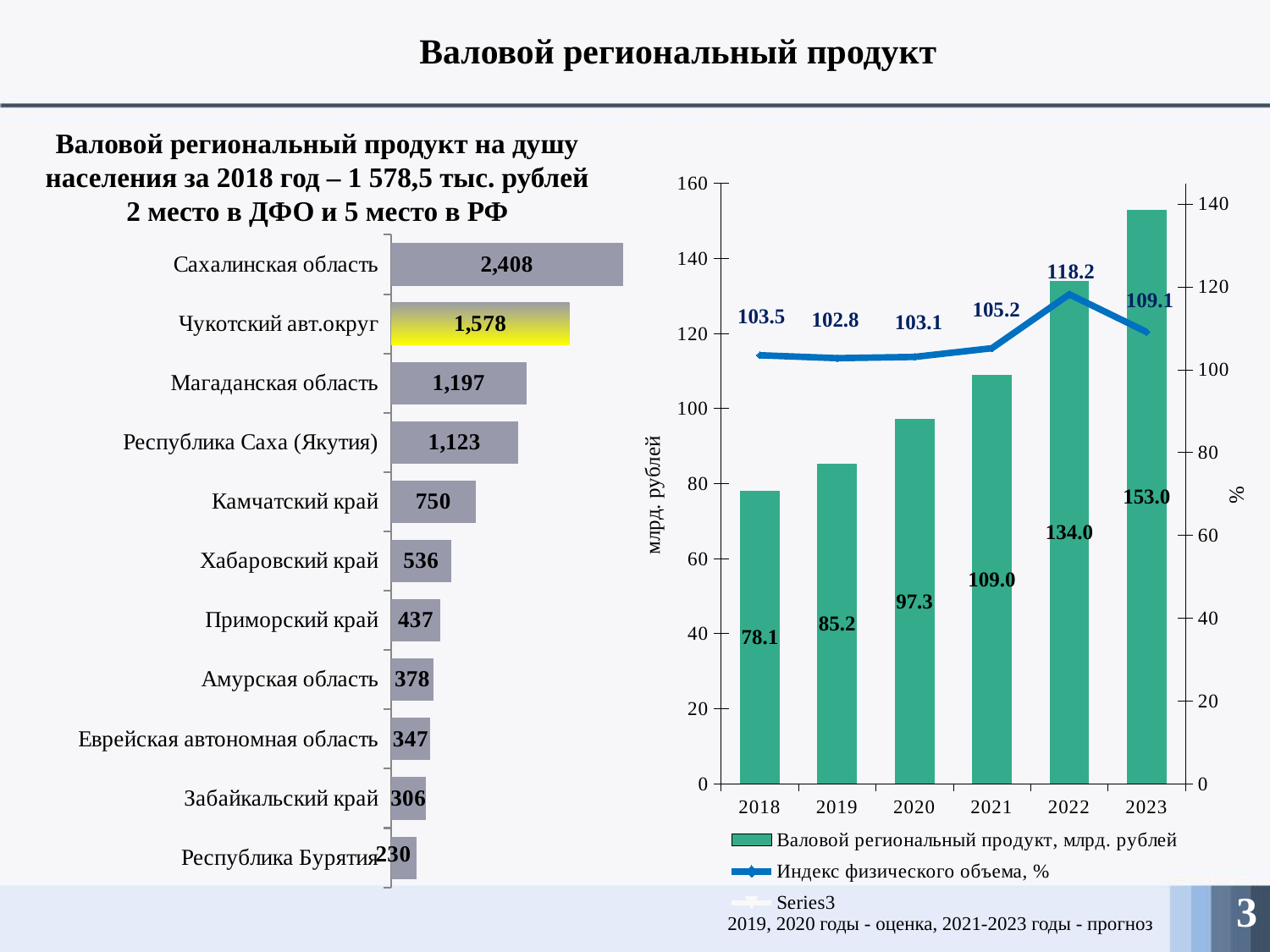
In the right chart, which year has the highest Валовой региональный продукт? 2023 In the left chart, what is the value for Сахалинская область? 2,408 In the right chart, does Валовой региональный продукт rise or fall from 2018 to 2023? rise In the right chart, what is the difference in Валовой региональный продукт between 2023 and 2018? 74.9 In the left chart, which is larger: Камчатский край or Хабаровский край? Камчатский край In the left chart, which region has the lowest value? Республика Бурятия In the right chart, what is the value of Индекс физического объема, % for 2022? 118.2 In the left chart, how many regions are listed? 11 In the right chart, what is the value of Валовой региональный продукт, млрд. рублей for 2021? 109.0 In the right chart, which year has the lowest Индекс физического объема, %? 2019 In the left chart, what is the difference between Сахалинская область and Чукотский авт.округ? 830 What type of chart is the left chart? bar chart